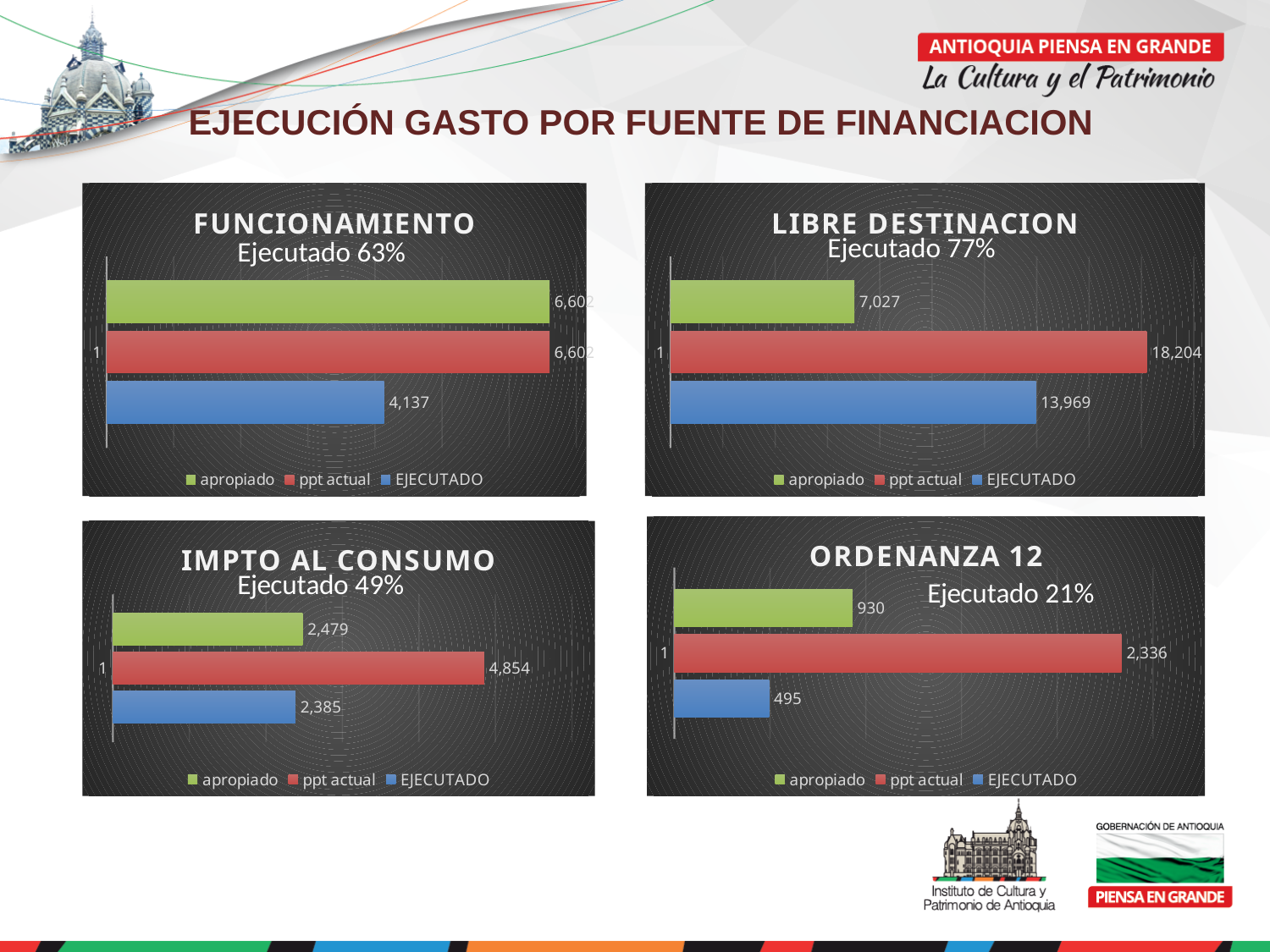
In the LIBRE DESTINACION chart, what is the value for apropiado? 7,027 In the LIBRE DESTINACION chart, which is larger, apropiado or EJECUTADO? EJECUTADO In the IMPTO AL CONSUMO chart, what is the difference between ppt actual and EJECUTADO? 2,469 In the LIBRE DESTINACION chart, which series has the highest value? ppt actual In the ORDENANZA 12 chart, which series has the lowest value? EJECUTADO In the ORDENANZA 12 chart, what is the difference between apropiado and EJECUTADO? 435 In the LIBRE DESTINACION chart, what is the value for ppt actual? 18,204 In the FUNCIONAMIENTO chart, what is the value for EJECUTADO? 4,137 What type of chart is the IMPTO AL CONSUMO chart? Bar chart In the ORDENANZA 12 chart, what is the value for ppt actual? 2,336 How many series does the legend of the FUNCIONAMIENTO chart list? 3 In the IMPTO AL CONSUMO chart, what is the value for EJECUTADO? 2,385